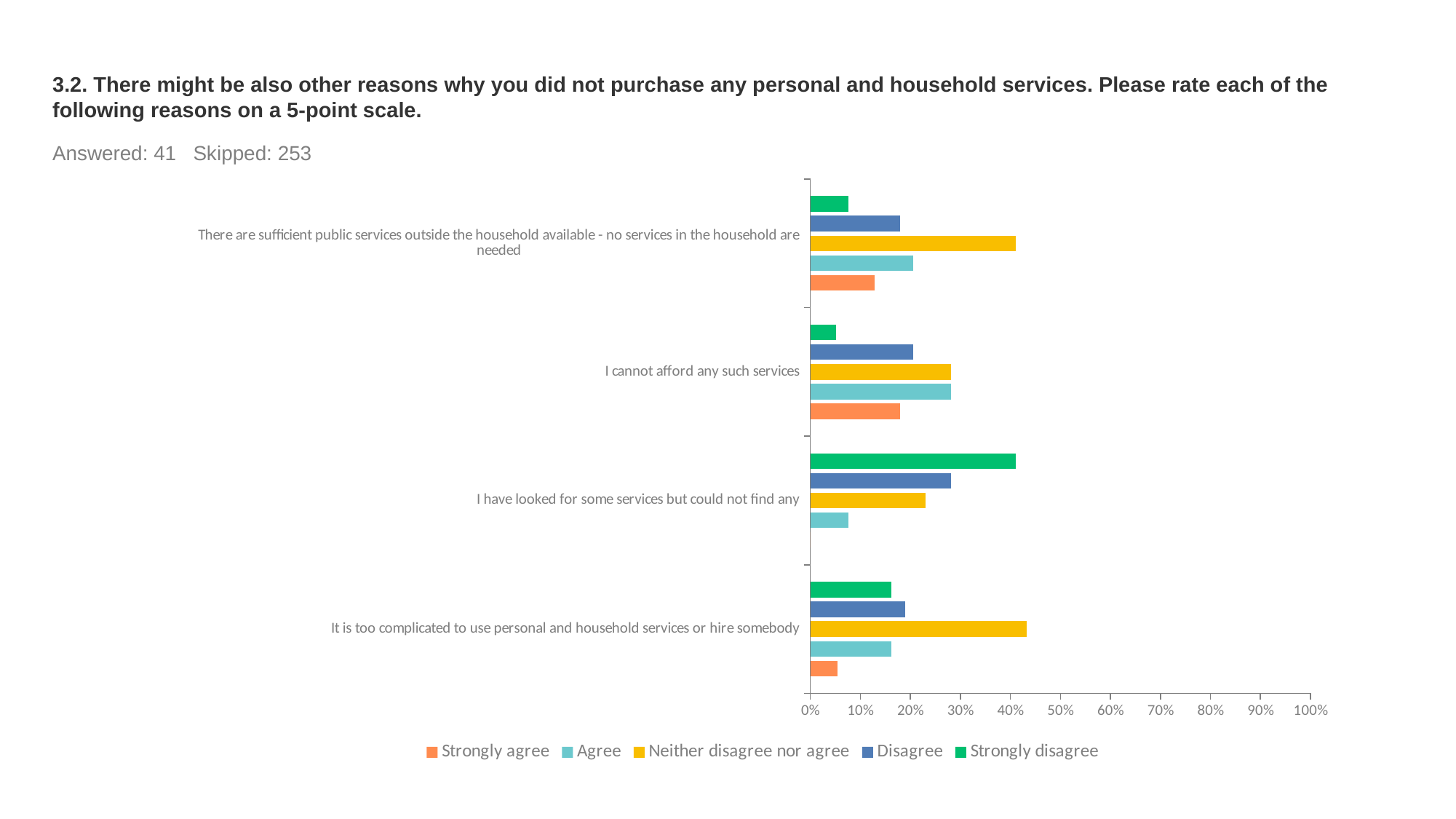
How many series does the legend list? 5 For 'There are sufficient public services outside the household available - no services in the household are needed', which is larger: Agree or Strongly agree? Agree For 'I cannot afford any such services', which is larger: Disagree or Strongly disagree? Disagree Is the 'Neither disagree nor agree' value for 'It is too complicated to use personal and household services or hire somebody' greater or less than 40%? greater What colour represents 'Neither disagree nor agree' in the legend? yellow How many reasons (categories) are plotted on the chart? 4 For 'I have looked for some services but could not find any', which response has the longest bar? Strongly disagree For 'It is too complicated to use personal and household services or hire somebody', which response has the shortest bar? Strongly agree Is the 'Strongly disagree' value for 'I have looked for some services but could not find any' greater or less than 30%? greater What kind of chart is shown on the slide? bar chart Is the 'Strongly disagree' value for 'I cannot afford any such services' greater or less than 10%? less What is the maximum value shown on the x axis? 100%